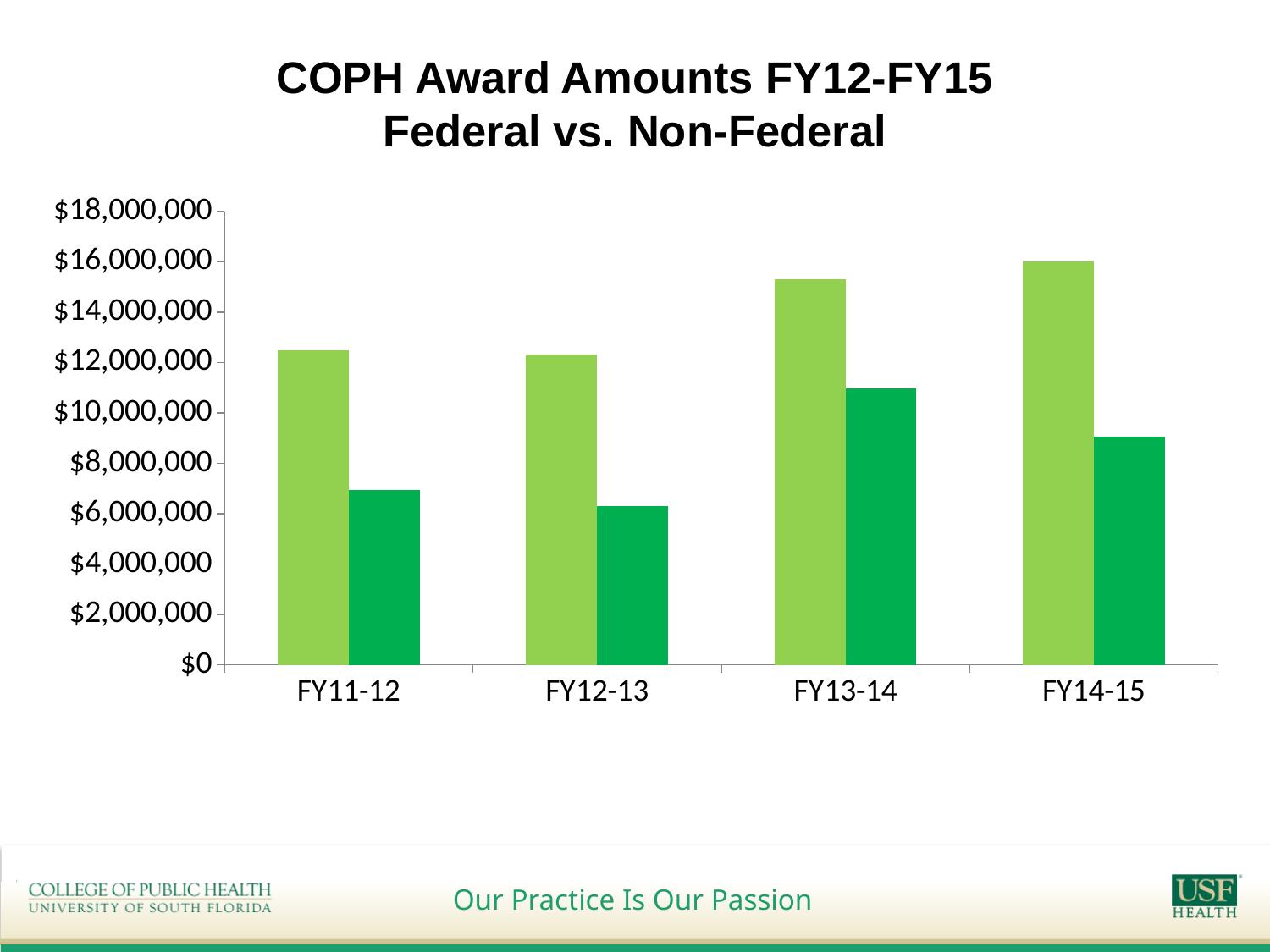
How many fiscal years are shown on the x axis of the chart? 4 What kind of chart is shown on the slide? bar chart In which fiscal year is the dark green bar the highest? FY13-14 Is the value of the light green bar for FY13-14 greater or less than $14,000,000? greater In which fiscal year is the light green bar the highest? FY14-15 Is the value of the dark green bar for FY14-15 greater or less than $8,000,000? greater What is the title of the chart? COPH Award Amounts FY12-FY15 Federal vs. Non-Federal For FY13-14, which bar is larger, the light green bar or the dark green bar? light green bar Is the value of the light green bar for FY11-12 greater or less than $12,000,000? greater In which fiscal year is the dark green bar the lowest? FY12-13